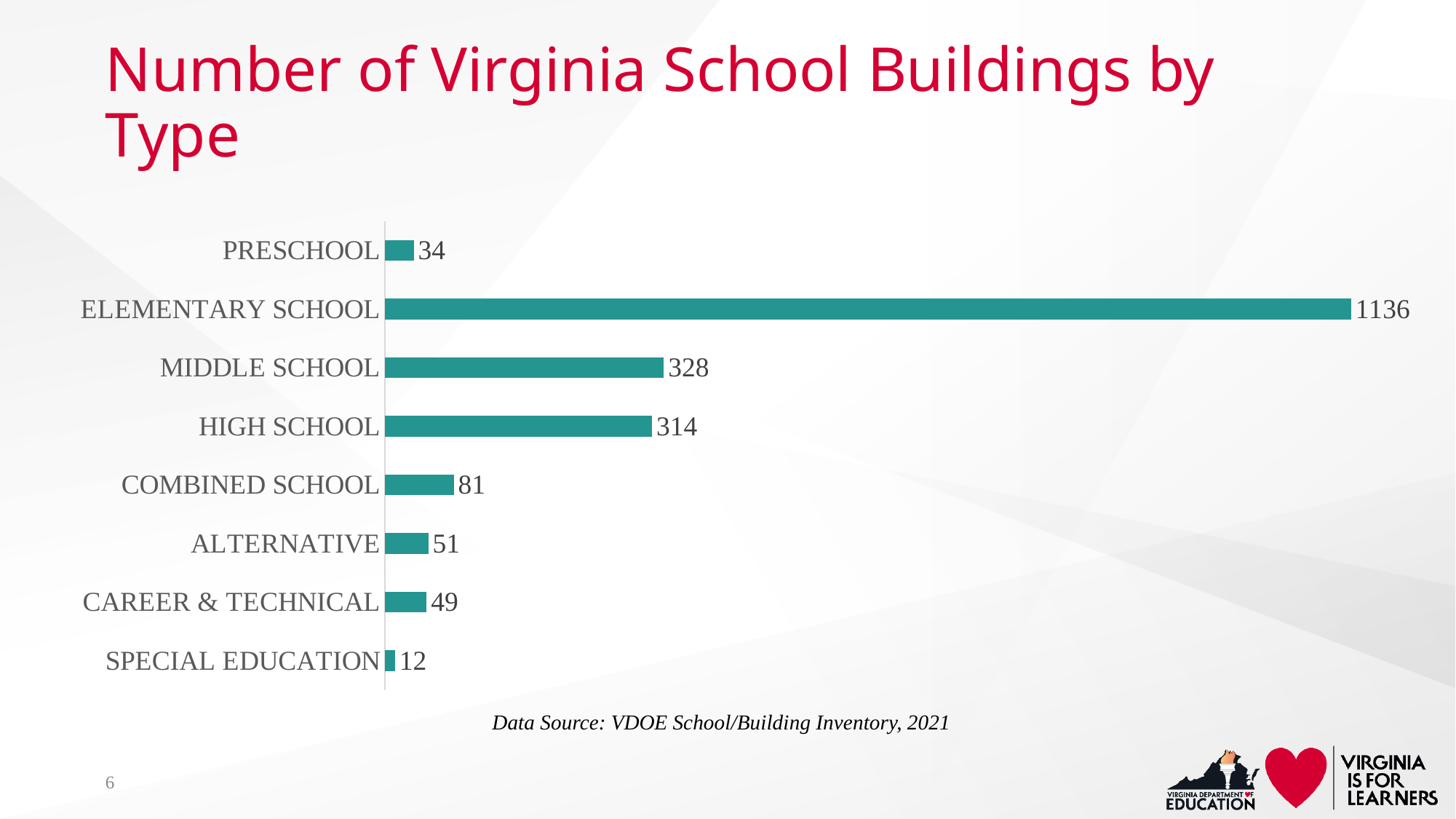
What is the difference between the Combined School and Preschool values? 47 What is the value for Career & Technical? 49 Which school building type has the lowest count? Special Education Which school building type has the highest count? Elementary School What kind of chart is shown on the slide? Bar chart How many school building types are shown on the chart? 8 What is the difference between the Middle School and High School values? 14 Which is larger, the value for Alternative or the value for Career & Technical? Alternative What is the value for Special Education? 12 How many elementary school buildings are shown on the chart? 1136 What data source is cited below the chart? VDOE School/Building Inventory, 2021 What is the value for Middle School? 328